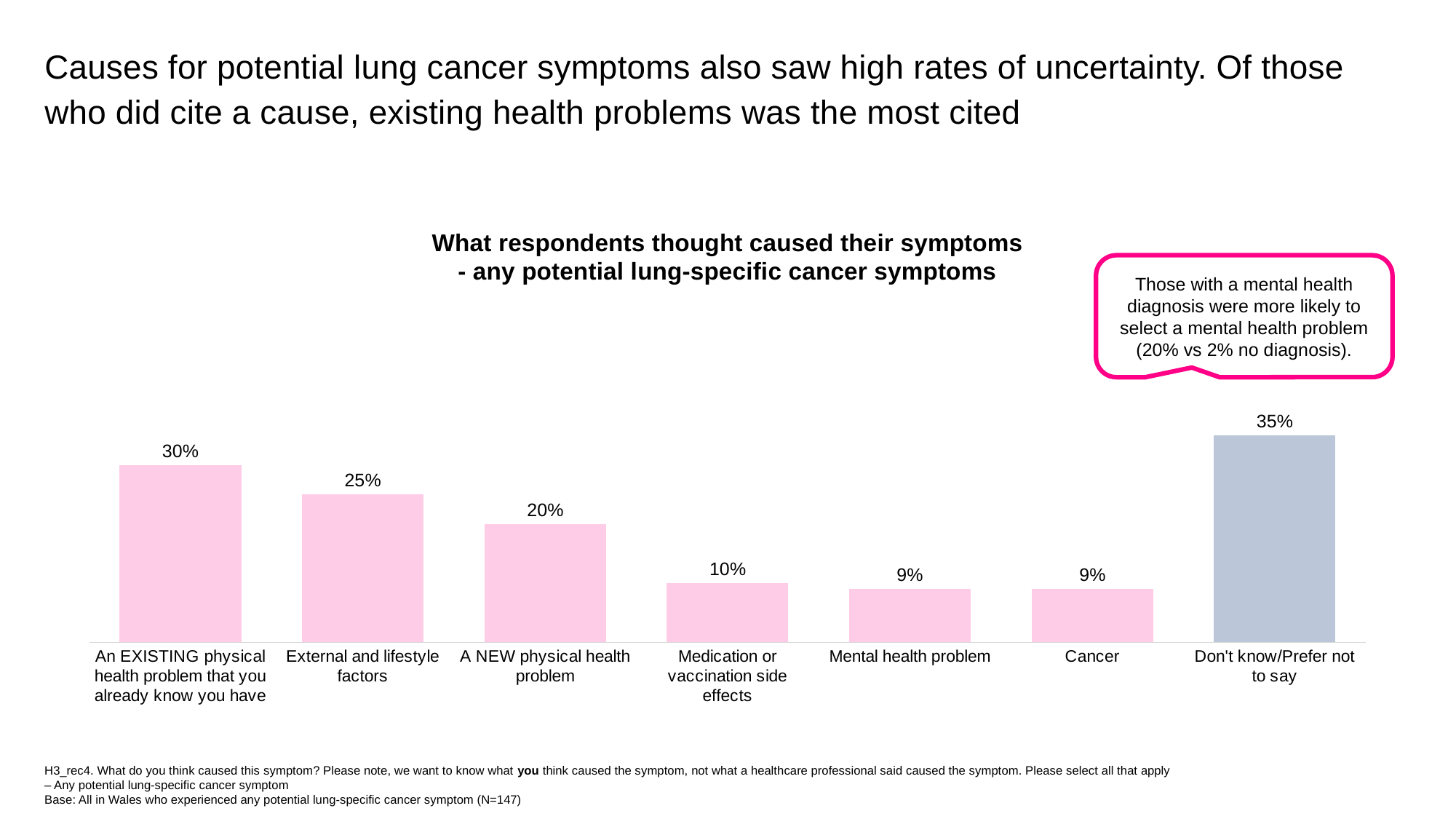
Which category has the highest value in the chart? Don't know/Prefer not to say Which bar is coloured differently (grey-blue) from the other pink bars? Don't know/Prefer not to say What is the difference between the value for 'Don't know/Prefer not to say' and the value for 'External and lifestyle factors'? 10% What is the title of the chart? What respondents thought caused their symptoms - any potential lung-specific cancer symptoms Which is larger: the value for 'A NEW physical health problem' or the value for 'Medication or vaccination side effects'? A NEW physical health problem What value is shown for 'Cancer'? 9% What percentage of respondents selected 'Medication or vaccination side effects'? 10% What type of chart is shown on the slide? Bar chart What value is shown for 'External and lifestyle factors'? 25% What percentage of respondents cited an existing physical health problem that they already know they have as the cause of their symptoms? 30% How many categories are shown in the chart? 7 What is the difference between the value for 'An EXISTING physical health problem that you already know you have' and the value for 'A NEW physical health problem'? 10%